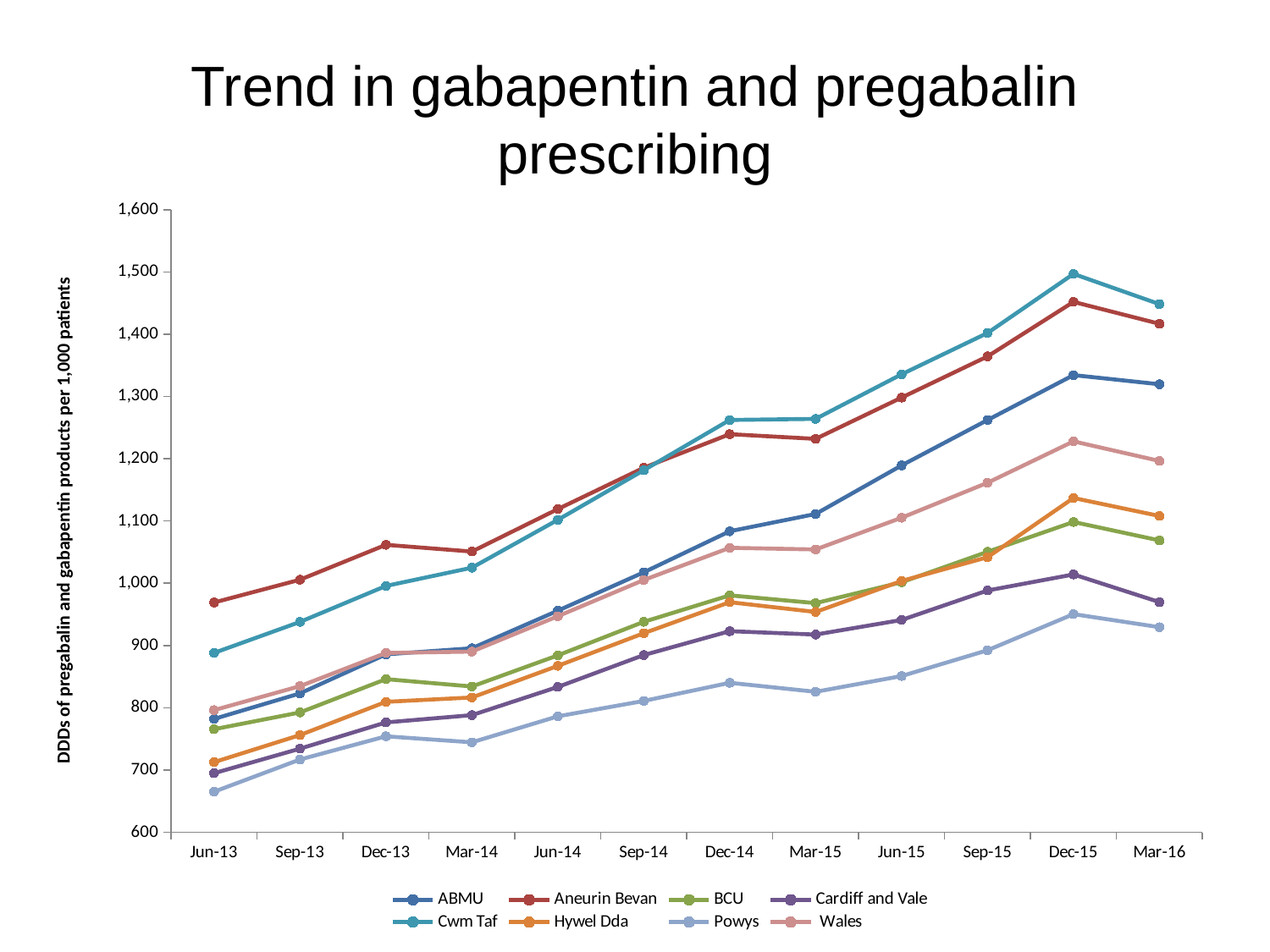
What is the title of the y axis? DDDs of pregabalin and gabapentin products per 1,000 patients Which series has the highest value at Jun-13? Aneurin Bevan How many series does the legend list? 8 Is the value for Powys at Jun-13 greater or less than 700? less What kind of chart is shown on the slide? Line chart How many time points are shown along the x axis? 12 Does the Cwm Taf line generally rise or fall from Jun-13 to Dec-15? rise Which series has the highest value at Mar-16? Cwm Taf At Mar-16, which is larger: the value for Powys or the value for Cardiff and Vale? Cardiff and Vale Which series has the lowest value at Jun-13? Powys Is the value for Cardiff and Vale at Mar-16 greater or less than 1,000? less Is the value for Cwm Taf at Dec-15 greater or less than 1,400? greater